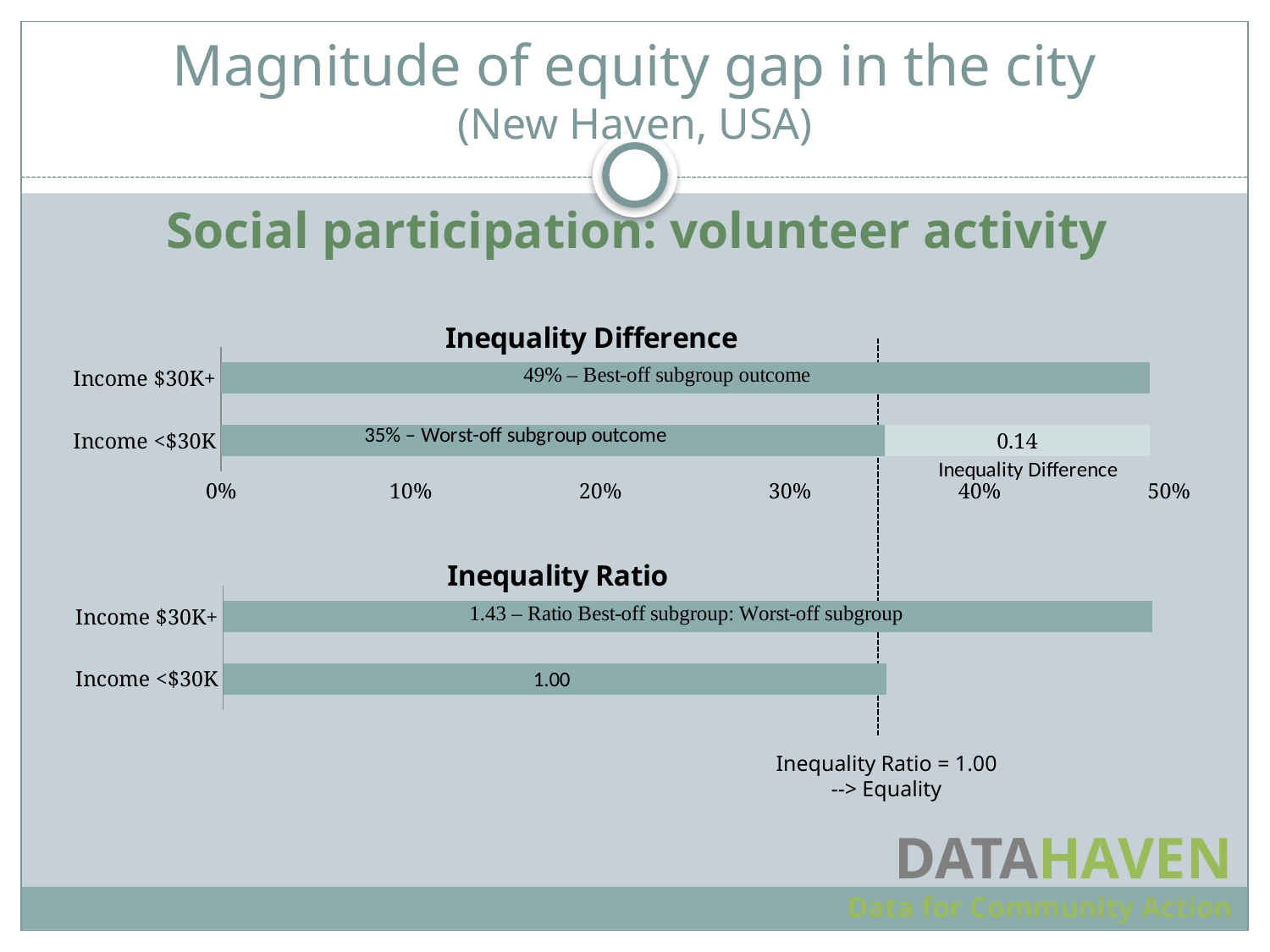
In the Inequality Difference chart, what is the value for Income $30K+? 49% How many income categories are shown in the Inequality Ratio chart? 2 What kind of chart is the Inequality Difference chart? Bar chart In the Inequality Difference chart, is the value for Income $30K+ greater or less than 50%? less In the Inequality Ratio chart, what is the value for Income $30K+? 1.43 In the Inequality Ratio chart, which group is labelled as the best-off subgroup? Income $30K+ In the Inequality Difference chart, which income group has the higher value? Income $30K+ In the Inequality Ratio chart, which income group has the lower value? Income <$30K In the Inequality Difference chart, what is the value for Income <$30K? 35% In the Inequality Difference chart, is the value for Income <$30K greater or less than 30%? greater In the Inequality Difference chart, what is the inequality difference shown between the two income groups? 0.14 In the Inequality Ratio chart, what is the value for Income <$30K? 1.00